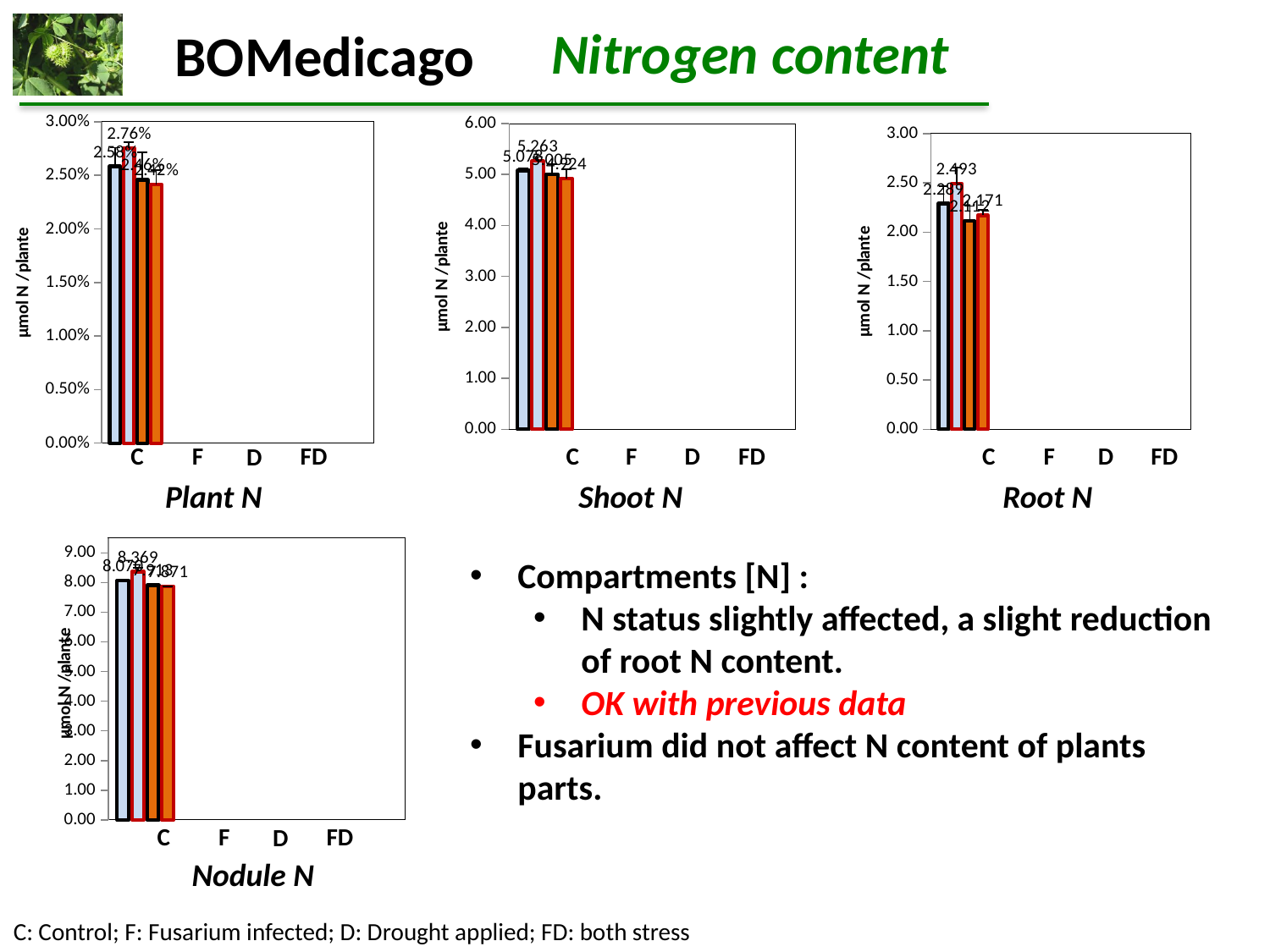
In the Plant N chart, what is the value for F? 2.76% In the Root N chart, is the value for D greater or less than 2.50? less In the Shoot N chart, is the value for C greater or less than 4.00? greater In the Root N chart, what is the difference between the values for F and FD? 0.322 In the Nodule N chart, which category has the highest value? F In the Root N chart, which category has the highest value? F What kind of chart is the Plant N chart? bar chart How many categories are shown on the x axis of the Shoot N chart? 4 In the Nodule N chart, what is the value for F? 8.369 In the Shoot N chart, what is the value for F? 5.263 In the Root N chart, what is the value for FD? 2.171 In the Root N chart, what is the value for F? 2.493